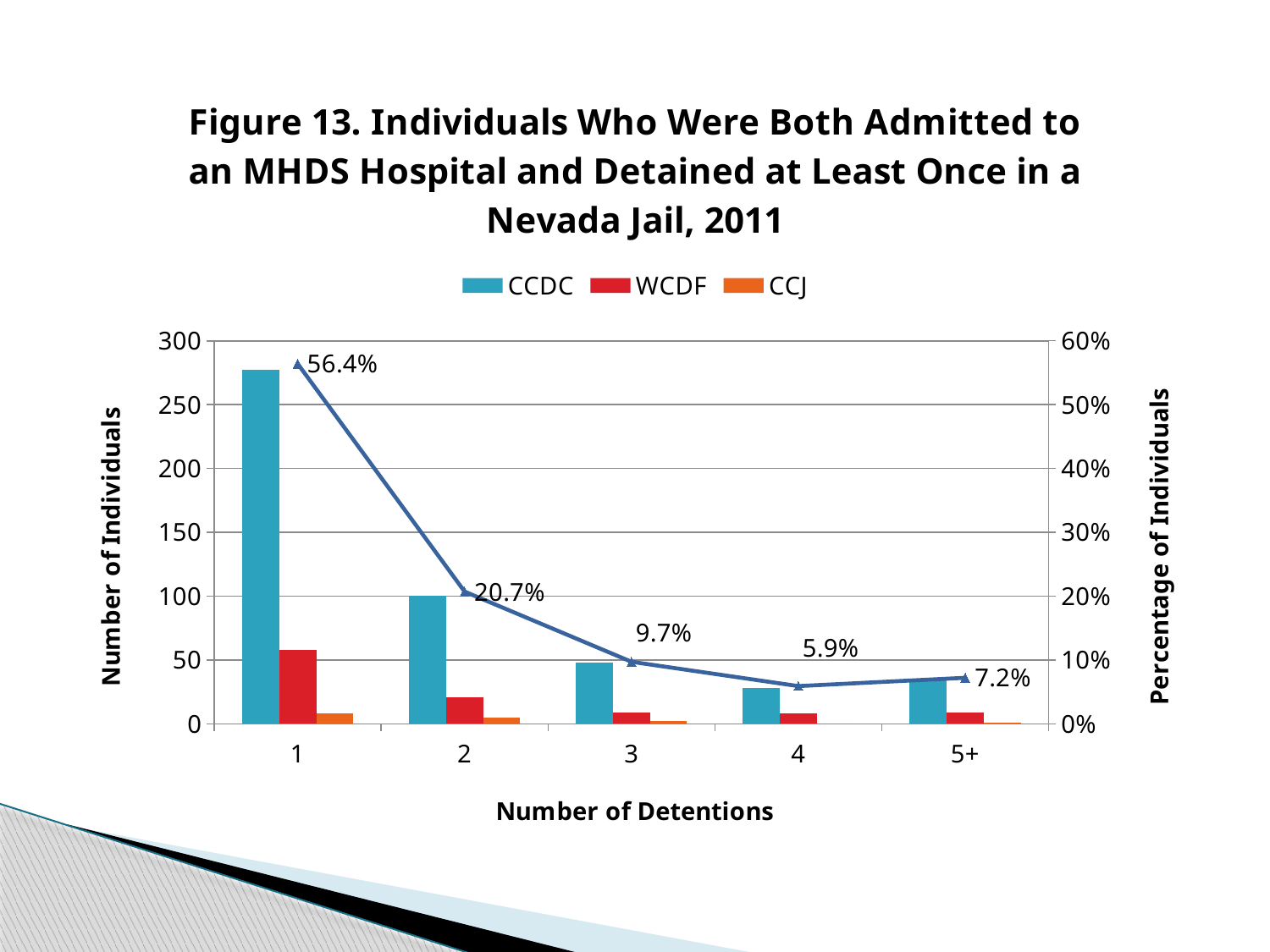
Which number of detentions has the highest percentage of individuals on the line? 1 What percentage of individuals is labelled on the line for 5+ detentions? 7.2% What percentage of individuals is labelled on the line for 1 detention? 56.4% What is the difference in percentage points between the line values for 1 detention and 2 detentions? 35.7 percentage points Which number of detentions has the lowest percentage of individuals on the line? 4 Is the CCDC value for 4 detentions greater or less than 50? less What percentage of individuals is labelled on the line for 3 detentions? 9.7% Which is larger, the percentage for 4 detentions or the percentage for 5+ detentions? 5+ detentions (7.2%) How many series does the legend list? 3 Does the percentage line rise or fall from 1 detention to 4 detentions? fall How many number-of-detentions categories are shown on the x axis? 5 Is the CCDC value for 1 detention greater or less than 250? greater